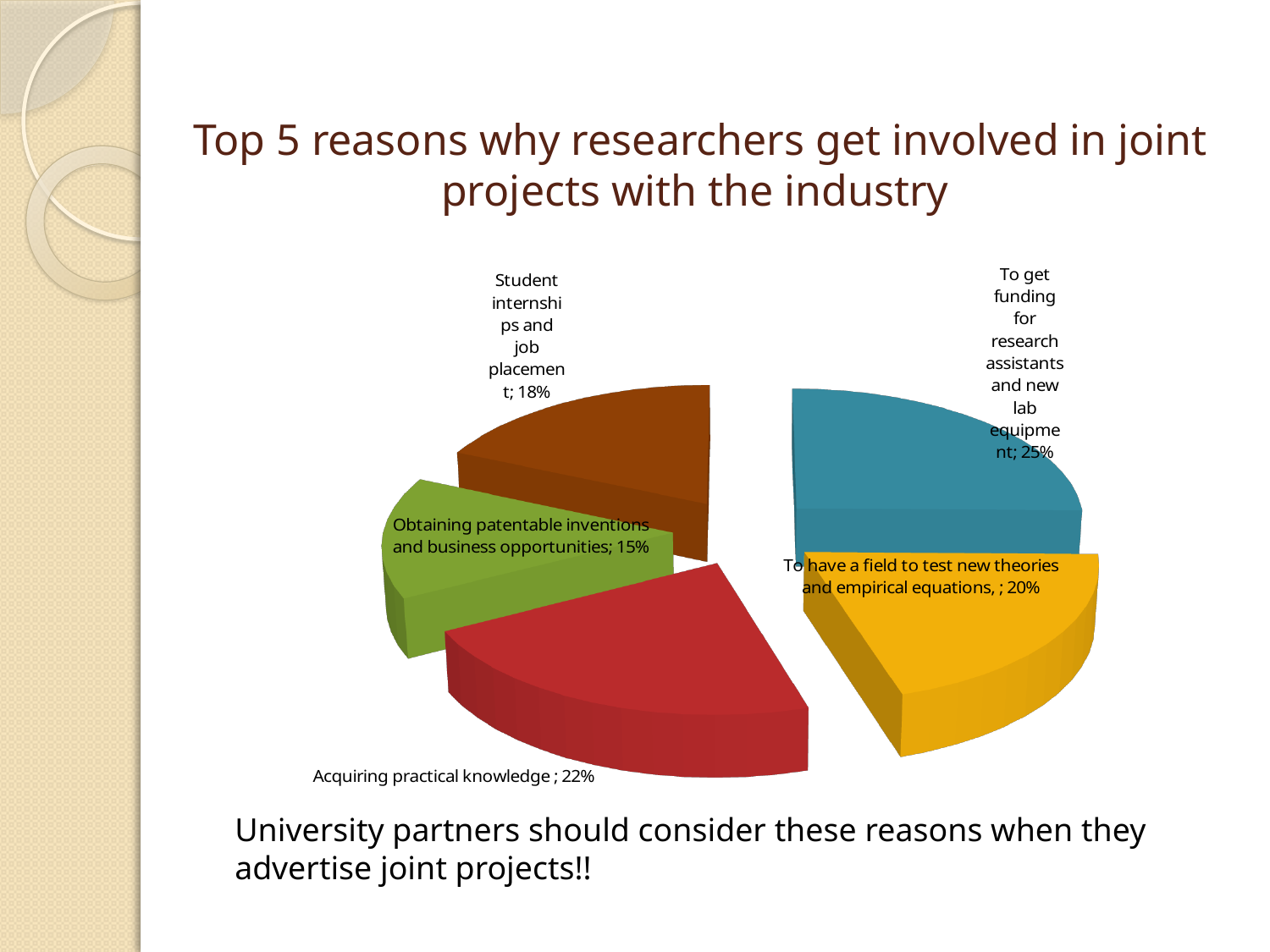
What percentage is shown for 'Student internships and job placement'? 18% What percentage is shown for 'Obtaining patentable inventions and business opportunities'? 15% Which reason has the largest share of the pie? To get funding for research assistants and new lab equipment What kind of chart is shown on the slide? Pie chart How many slices does the pie chart have? 5 What is the difference in percentage points between 'To get funding for research assistants and new lab equipment' and 'Obtaining patentable inventions and business opportunities'? 10 percentage points What colour is the slice for 'Acquiring practical knowledge'? Red What percentage is shown for 'To have a field to test new theories and empirical equations'? 20% What share of the pie is labelled 'Acquiring practical knowledge'? 22% What is the title of the chart? Top 5 reasons why researchers get involved in joint projects with the industry Which has a larger share: 'Acquiring practical knowledge' or 'Student internships and job placement'? Acquiring practical knowledge Which reason has the smallest share of the pie? Obtaining patentable inventions and business opportunities